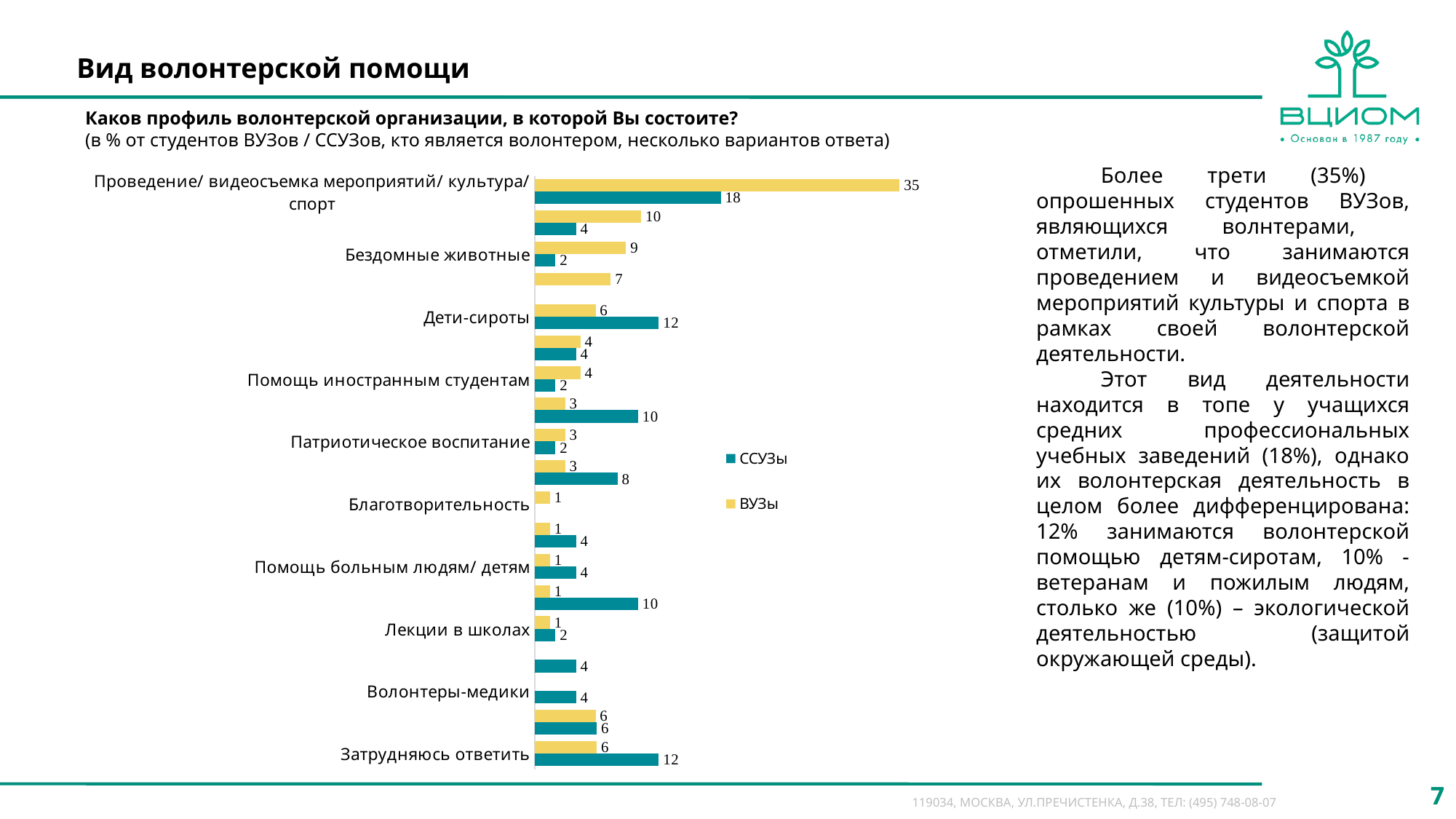
What is the value for ВУЗы for 'Бездомные животные'? 9 What is the value for ССУЗы for 'Проведение/ видеосъемка мероприятий/ культура/ спорт'? 18 How many series does the legend list? 2 Which colour represents the ВУЗы series in the legend? yellow What kind of chart is shown on the slide? bar chart What is the value for ВУЗы for 'Помощь больным людям/ детям'? 1 What is the value for ССУЗы for 'Затрудняюсь ответить'? 12 What is the value for ВУЗы for 'Проведение/ видеосъемка мероприятий/ культура/ спорт'? 35 What is the difference between the ВУЗы and ССУЗы values for 'Проведение/ видеосъемка мероприятий/ культура/ спорт'? 17 Which is larger for 'Дети-сироты': the ВУЗы value or the ССУЗы value? ССУЗы What is the value for ССУЗы for 'Дети-сироты'? 12 Which category has the highest value for ВУЗы? Проведение/ видеосъемка мероприятий/ культура/ спорт